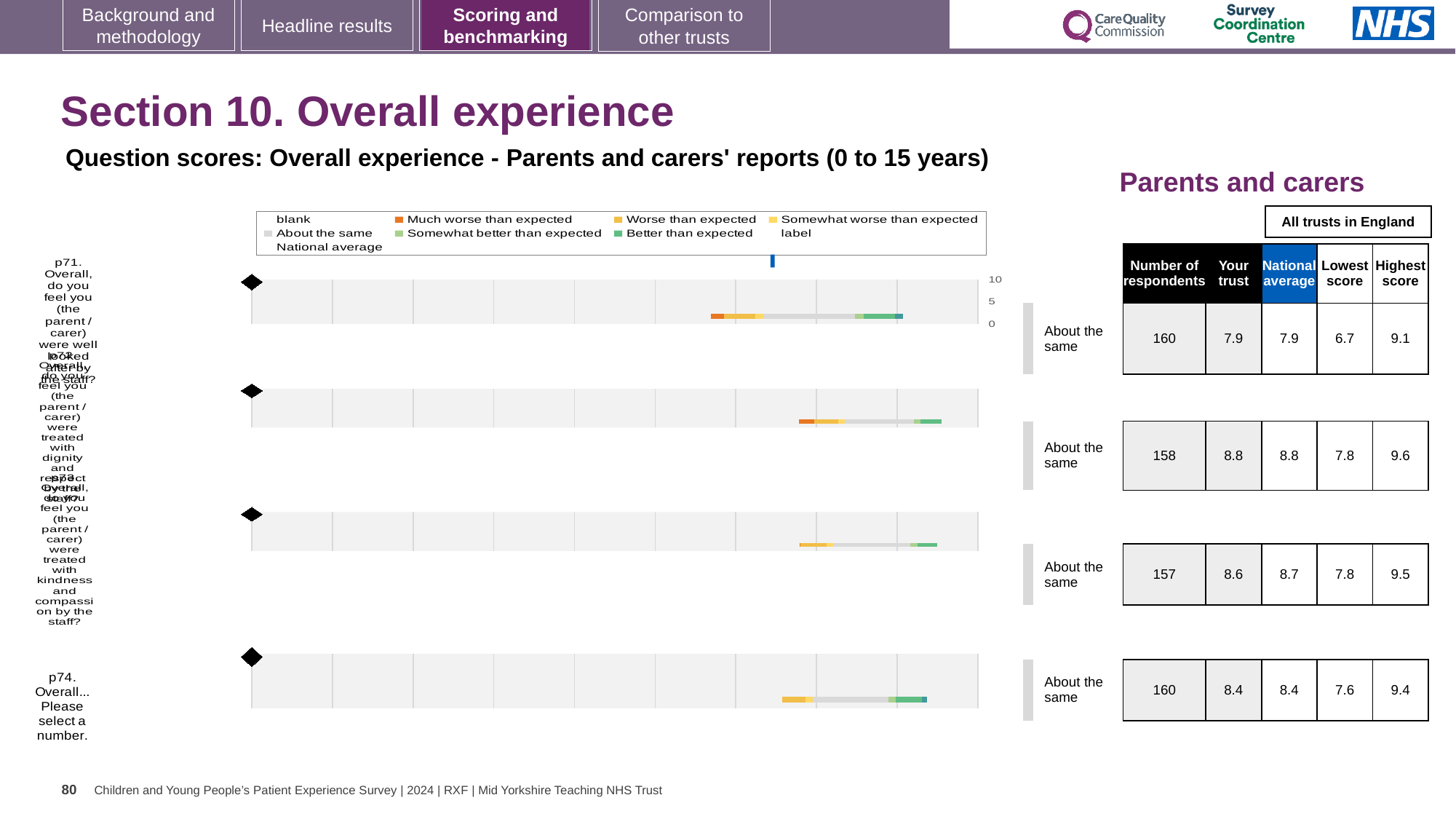
What is the highest value shown on the chart's numeric axis? 10 What kind of chart is used to show the question scores on this slide? bar chart According to the table beside the chart, what is the difference between the highest score and the lowest score for p71? 2.4 How many questions (rows) are plotted in the chart? 4 According to the table beside the chart, which question has the highest 'Your trust' score? p72 According to the table beside the chart, what is the 'Your trust' score for p71? 7.9 According to the table beside the chart, what is the highest score for p72? 9.6 According to the table beside the chart, how many respondents answered p73? 157 What colour does the legend use for 'Much worse than expected'? orange According to the table beside the chart, what is the 'Your trust' score for p74? 8.4 According to the table beside the chart, what is the national average for p73? 8.7 What benchmark category is shown next to the chart for question p74? About the same